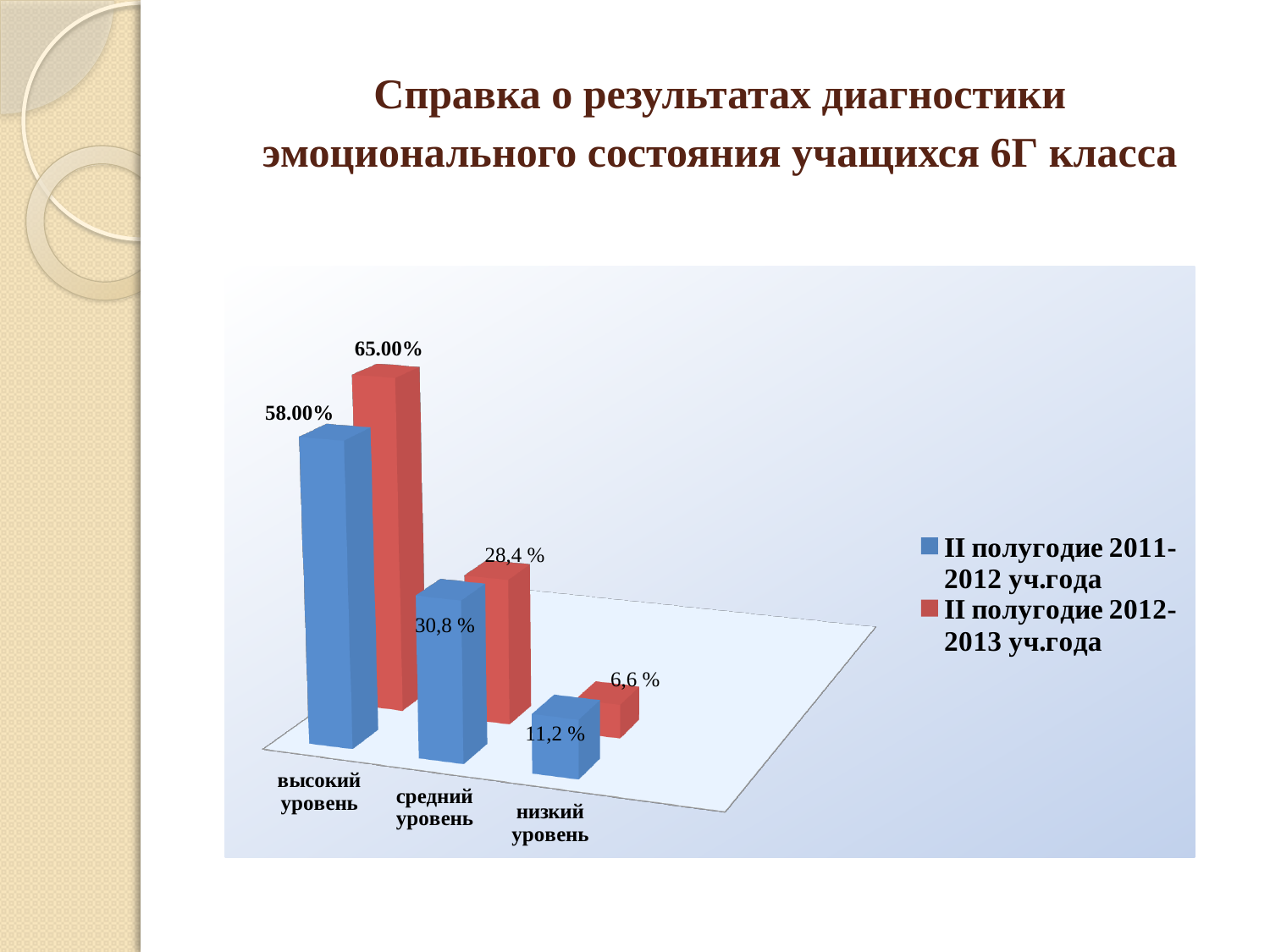
What is the value for высокий уровень in the II полугодие 2012-2013 уч.года series? 65.00% Which category has the highest value in the II полугодие 2012-2013 уч.года series? высокий уровень How many categories are shown on the chart? 3 What is the value for высокий уровень in the II полугодие 2011-2012 уч.года series? 58.00% What is the value for средний уровень in the II полугодие 2011-2012 уч.года series? 30,8 % What kind of chart is shown on the slide? Bar chart How many series does the legend list? 2 Which category has the lowest value in the II полугодие 2011-2012 уч.года series? низкий уровень By how many percentage points does the II полугодие 2012-2013 уч.года value for высокий уровень exceed the II полугодие 2011-2012 уч.года value? 7 percentage points Which colour represents the II полугодие 2012-2013 уч.года series? Red What is the value for низкий уровень in the II полугодие 2012-2013 уч.года series? 6,6 % Which series has the larger value for низкий уровень? II полугодие 2011-2012 уч.года